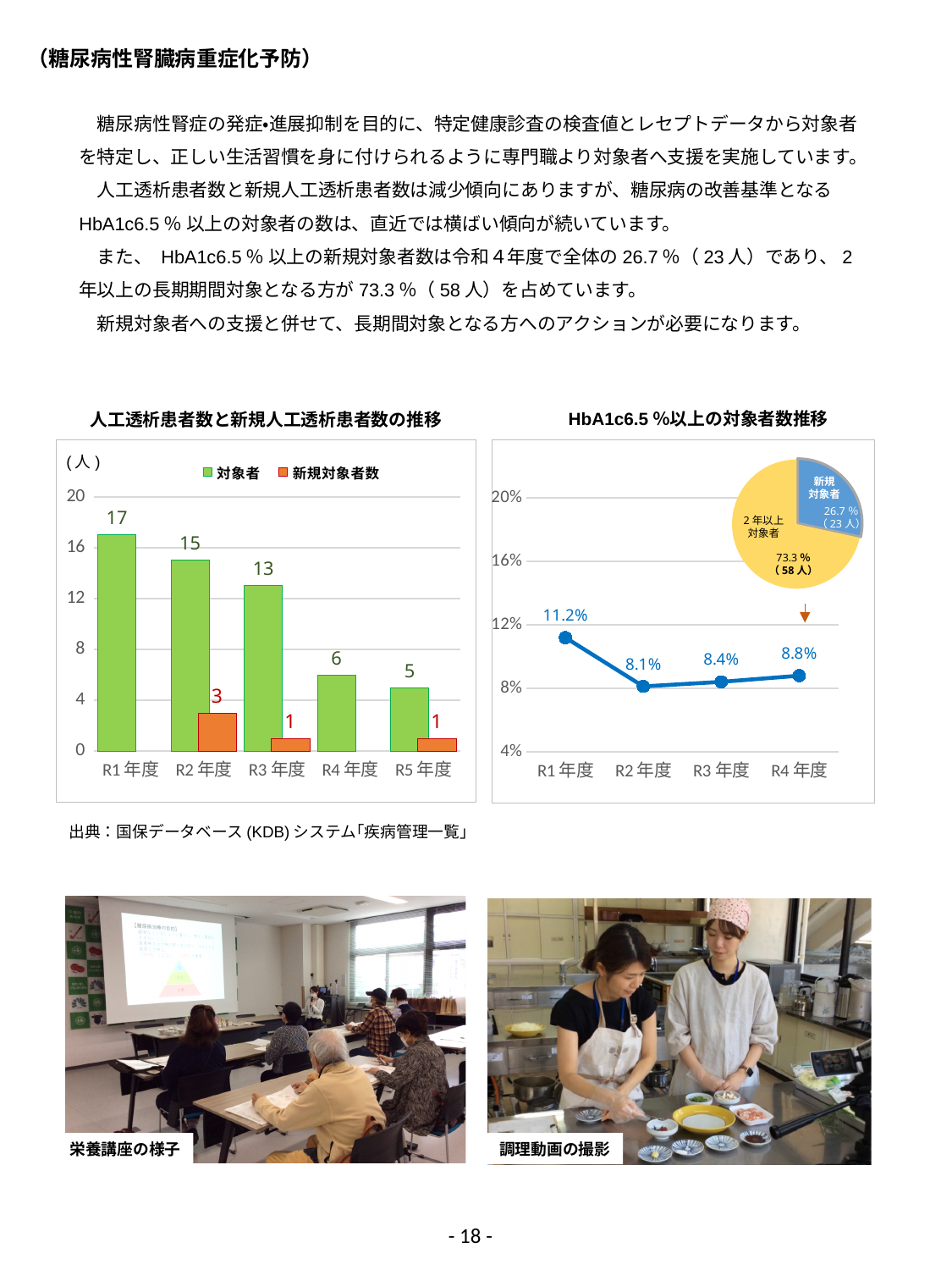
In the chart titled 人工透析患者数と新規人工透析患者数の推移, what is the value for 対象者 in R1年度? 17 In the chart titled 人工透析患者数と新規人工透析患者数の推移, what is the difference between the 対象者 values for R1年度 and R5年度? 12 In the chart titled 人工透析患者数と新規人工透析患者数の推移, which year has the highest value for 対象者? R1年度 In the chart titled 人工透析患者数と新規人工透析患者数の推移, what is the value for 新規対象者数 in R2年度? 3 In the chart titled 人工透析患者数と新規人工透析患者数の推移, which year has the lowest value for 対象者? R5年度 In the chart titled HbA1c6.5％以上の対象者数推移, which year has the lowest value on the line? R2年度 In the chart titled 人工透析患者数と新規人工透析患者数の推移, do the 対象者 values rise or fall from R1年度 to R5年度? fall In the chart titled HbA1c6.5％以上の対象者数推移, how many years are plotted on the line? 4 In the pie inset of the chart titled HbA1c6.5％以上の対象者数推移, what share is 新規対象者? 26.7% What kind of chart is the chart titled 人工透析患者数と新規人工透析患者数の推移? bar chart In the chart titled 人工透析患者数と新規人工透析患者数の推移, how many series does the legend list? 2 In the chart titled HbA1c6.5％以上の対象者数推移, what is the value for R1年度? 11.2%